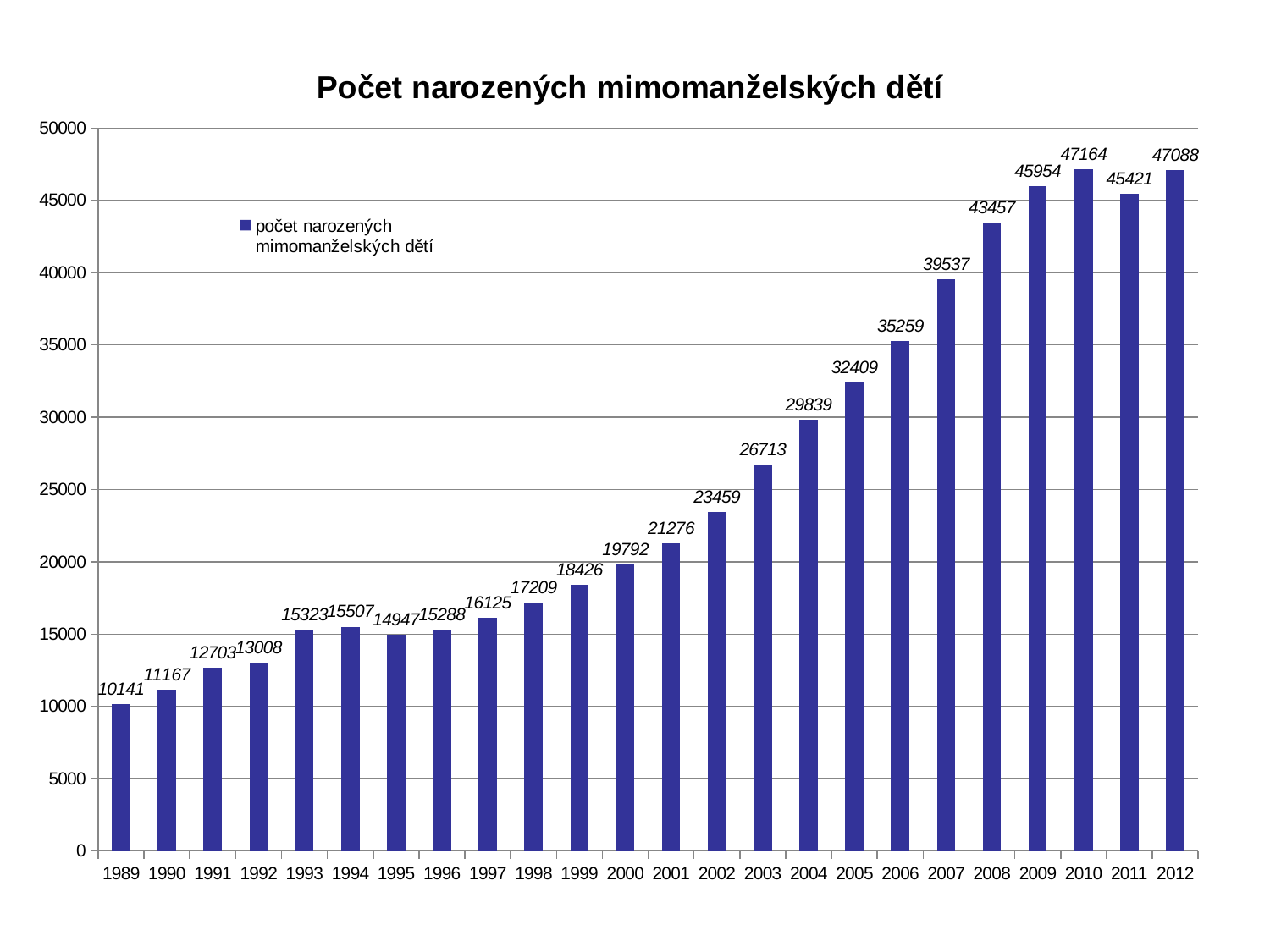
Which year has the lowest value? 1989 Is the value for 2007 greater or less than 40000? less What is the difference between the values for 2012 and 1989? 36947 How many series does the legend list? 1 What is the value for 2005? 32409 Which is larger, the value for 1994 or the value for 1995? 1994 What is the value for 1989? 10141 What is the value for 2012? 47088 Which year has the highest value? 2010 What kind of chart is shown? bar chart What is the title of the chart? Počet narozených mimomanželských dětí How many years are shown on the x axis? 24